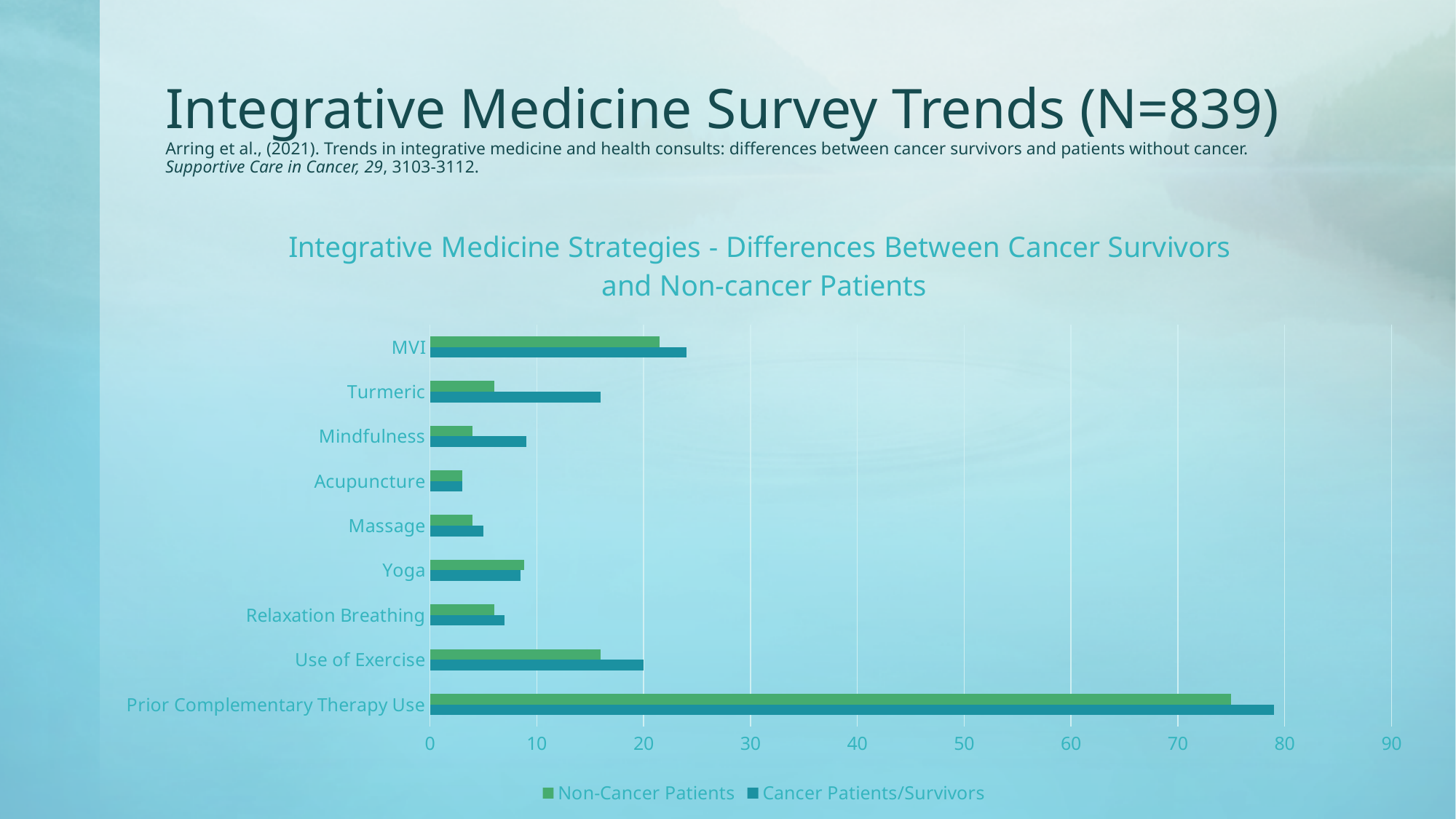
What kind of chart is shown on the slide? bar chart Is the Non-Cancer Patients value for Use of Exercise greater or less than 20? less Is the Cancer Patients/Survivors value for Turmeric greater or less than 10? greater Is the Cancer Patients/Survivors value for Prior Complementary Therapy Use greater or less than 70? greater For Use of Exercise, which series has the larger value, Non-Cancer Patients or Cancer Patients/Survivors? Cancer Patients/Survivors What is the title of the chart? Integrative Medicine Strategies - Differences Between Cancer Survivors and Non-cancer Patients How many categories are plotted on the chart? 9 How many series does the legend list? 2 Which category has the lowest value for Cancer Patients/Survivors? Acupuncture For Turmeric, which series has the larger value, Non-Cancer Patients or Cancer Patients/Survivors? Cancer Patients/Survivors Which category has the highest value for Cancer Patients/Survivors? Prior Complementary Therapy Use